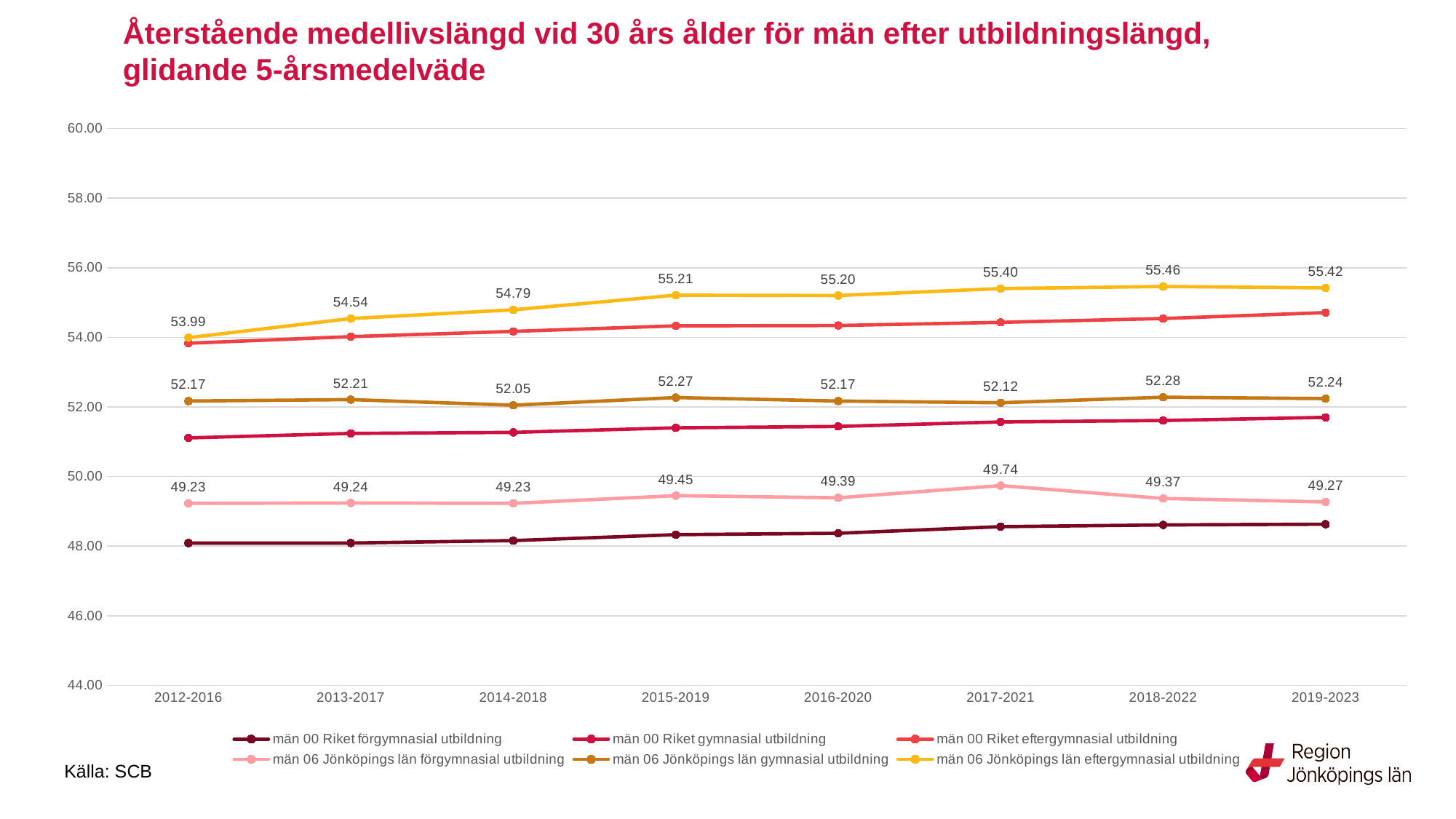
Which is larger for män 06 Jönköpings län förgymnasial utbildning: the value in 2015-2019 or in 2018-2022? 2015-2019 What type of chart is shown on the slide? line chart How many periods are shown on the x axis? 8 In which period is the value for män 06 Jönköpings län eftergymnasial utbildning highest? 2018-2022 Does the value for män 06 Jönköpings län eftergymnasial utbildning rise or fall from 2012-2016 to 2015-2019? rise In which period is the value for män 06 Jönköpings län gymnasial utbildning lowest? 2014-2018 What is the difference between the 2019-2023 and 2012-2016 values for män 06 Jönköpings län eftergymnasial utbildning? 1.43 How many series does the legend list? 6 What is the value for män 06 Jönköpings län gymnasial utbildning in 2014-2018? 52.05 What is the value for män 06 Jönköpings län förgymnasial utbildning in 2017-2021? 49.74 Is the value for män 00 Riket gymnasial utbildning in 2012-2016 greater or less than 52.00? less What is the value for män 06 Jönköpings län eftergymnasial utbildning in 2012-2016? 53.99